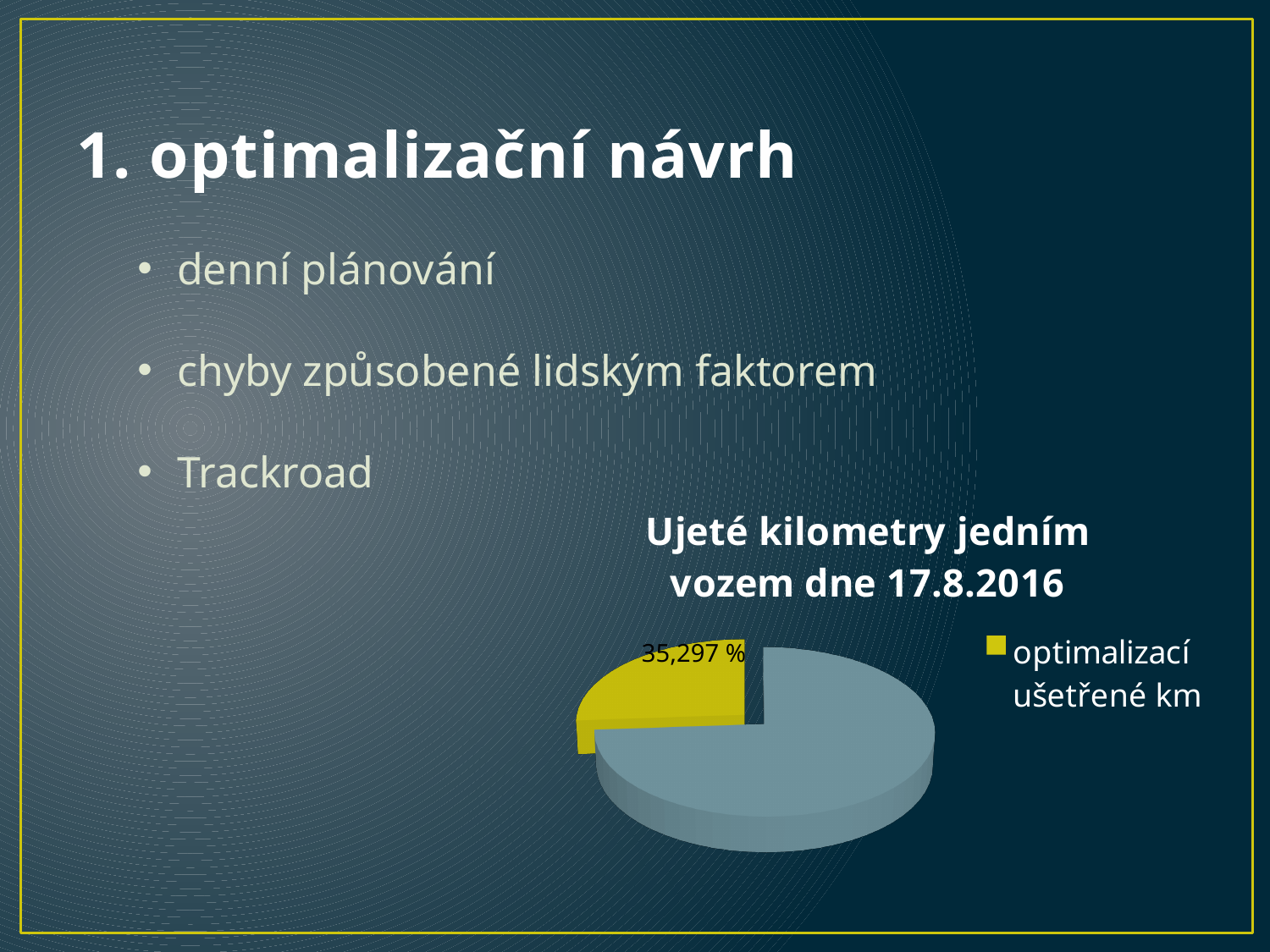
What is the value printed on the yellow slice of the pie chart? 35,297 % What share of the pie does the slice labelled in the legend as "optimalizací ušetřené km" represent? 35,297 % What kind of chart is shown on the slide? pie chart Which slice of the pie chart is the largest, the yellow one or the blue-grey one? the blue-grey one How many slices does the pie chart have? 2 Is the "optimalizací ušetřené km" slice larger or smaller than the other slice of the pie? smaller What is the title of the pie chart? Ujeté kilometry jedním vozem dne 17.8.2016 Which slice of the pie chart is the smallest, the yellow one or the blue-grey one? the yellow one How many entries does the legend of the pie chart list? 1 What is the legend entry shown next to the pie chart? optimalizací ušetřené km